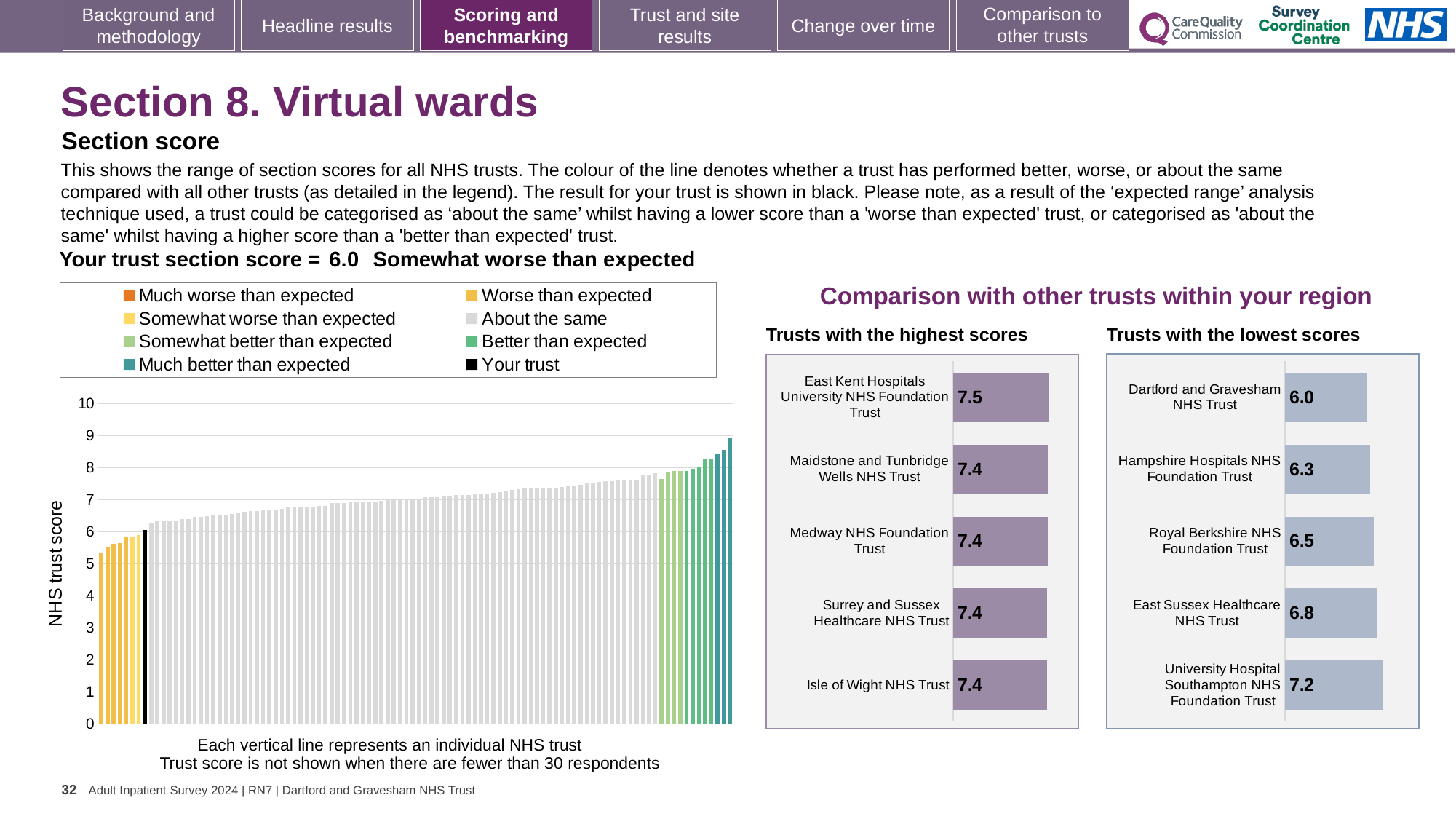
How many entries does the legend of the large chart on the left list? 8 In the 'Trusts with the lowest scores' chart, which has the higher score: Royal Berkshire NHS Foundation Trust or East Sussex Healthcare NHS Trust? East Sussex Healthcare NHS Trust In the 'Trusts with the highest scores' chart, what is the score for East Kent Hospitals University NHS Foundation Trust? 7.5 How many trusts are shown in the 'Trusts with the highest scores' chart? 5 What kind of chart is the 'Trusts with the lowest scores' chart? Bar chart In the large chart on the left, is the value of the tallest bar greater or less than 8? greater In the 'Trusts with the lowest scores' chart, what is the score for Hampshire Hospitals NHS Foundation Trust? 6.3 In the large chart on the left, what is the section score for your trust (the black bar)? 6.0 In the 'Trusts with the lowest scores' chart, which trust has the lowest score? Dartford and Gravesham NHS Trust In the large chart on the left showing all NHS trusts, do the bar values rise or fall from left to right? Rise In the 'Trusts with the lowest scores' chart, what is the difference between the scores of University Hospital Southampton NHS Foundation Trust and Dartford and Gravesham NHS Trust? 1.2 In the 'Trusts with the highest scores' chart, which trust has the highest score? East Kent Hospitals University NHS Foundation Trust